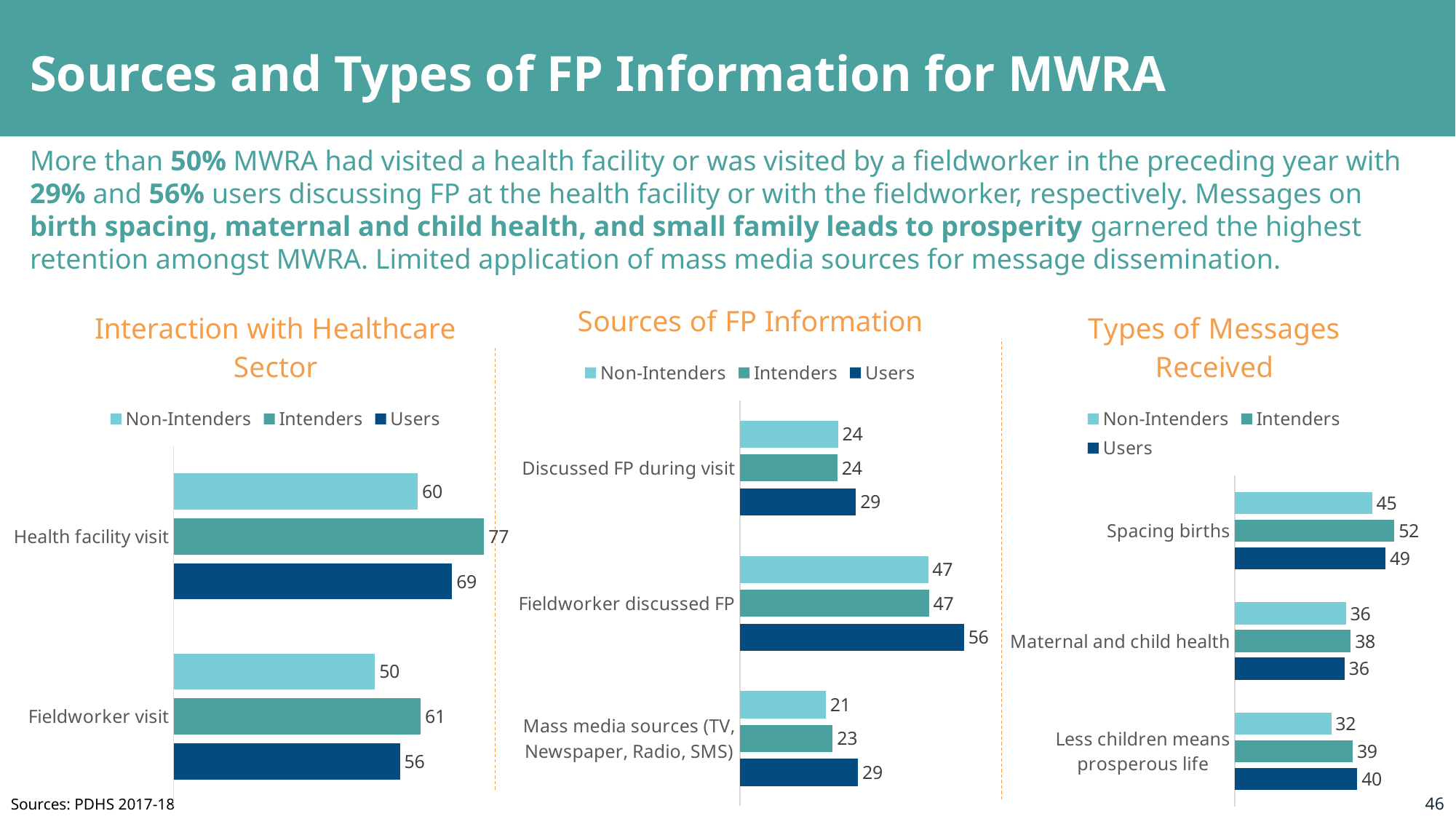
How many series does the legend of the 'Types of Messages Received' chart list? 3 What type of chart is the 'Interaction with Healthcare Sector' chart? Bar chart In the 'Interaction with Healthcare Sector' chart, what is the value for Users for Fieldworker visit? 56 In the 'Types of Messages Received' chart, what is the value for Intenders for Spacing births? 52 In the 'Sources of FP Information' chart, which series has the highest value for Mass media sources (TV, Newspaper, Radio, SMS)? Users In the 'Types of Messages Received' chart, which category has the lowest Non-Intenders value? Less children means prosperous life In the 'Sources of FP Information' chart, how many categories are shown? 3 In the 'Sources of FP Information' chart, is the Non-Intenders value for Fieldworker discussed FP larger or smaller than the Non-Intenders value for Discussed FP during visit? larger In the 'Interaction with Healthcare Sector' chart, what is the value for Intenders for Health facility visit? 77 In the 'Sources of FP Information' chart, what is the value for Users for Fieldworker discussed FP? 56 In the 'Types of Messages Received' chart, what is the difference between Users and Non-Intenders for Less children means prosperous life? 8 In the 'Interaction with Healthcare Sector' chart, what is the difference between Intenders and Non-Intenders for Health facility visit? 17